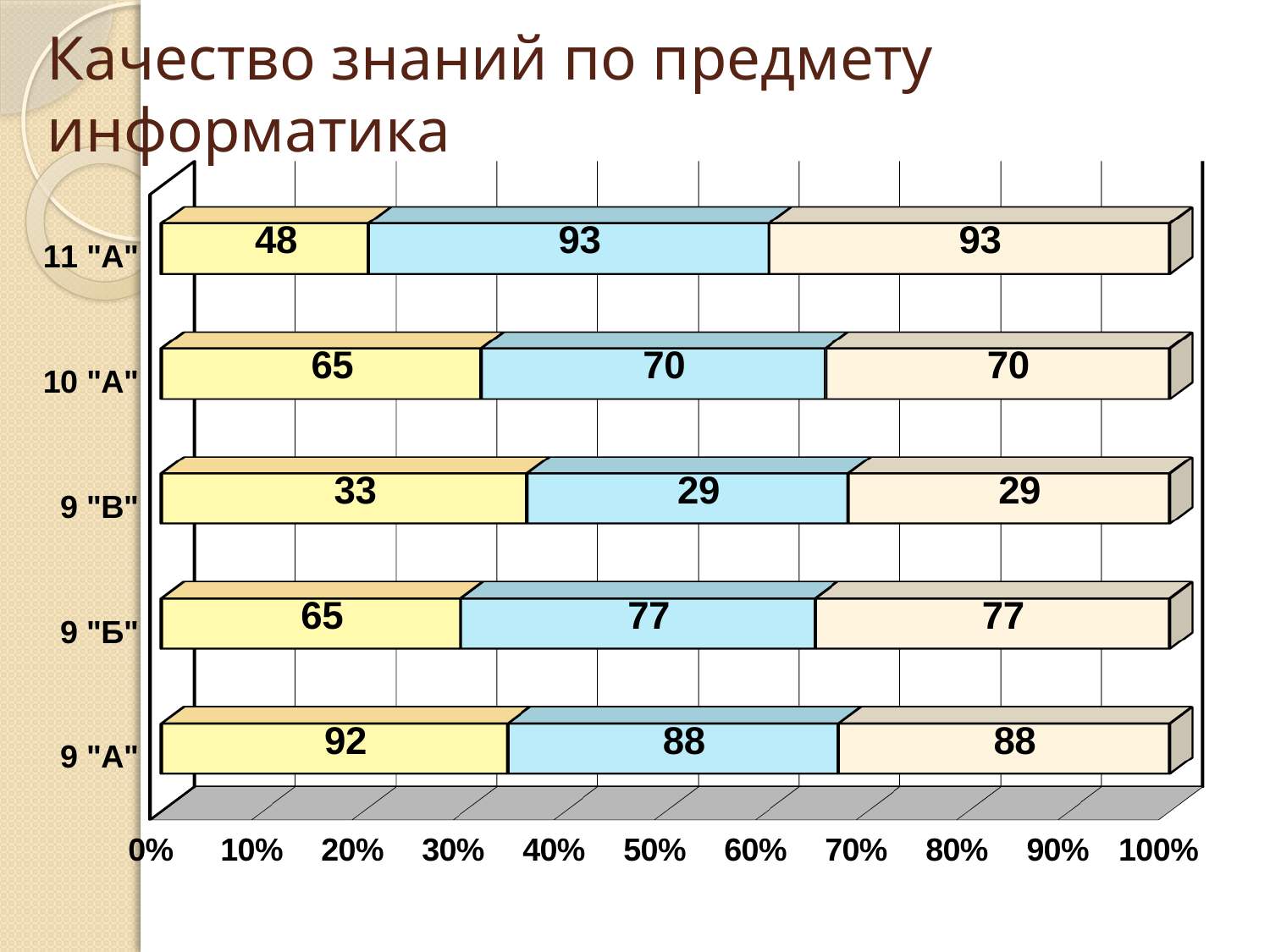
What is the value of the yellow segment for 9 "А"? 92 What kind of chart is shown on the slide? bar chart What is the value of the blue segment for 11 "А"? 93 Which class has the larger yellow segment value, 10 "А" or 11 "А"? 10 "А" Which class has the lowest value in the blue segment? 9 "В" What is the value of the yellow segment for 10 "А"? 65 Which class has the highest value in the yellow segment? 9 "А" Which class has the lowest value in the yellow segment? 9 "В" How many classes (categories) are shown on the chart? 5 What is the value of the beige (rightmost) segment for 9 "В"? 29 What is the difference between the yellow segment values for 9 "А" and 11 "А"? 44 What is the title of the chart? Качество знаний по предмету информатика